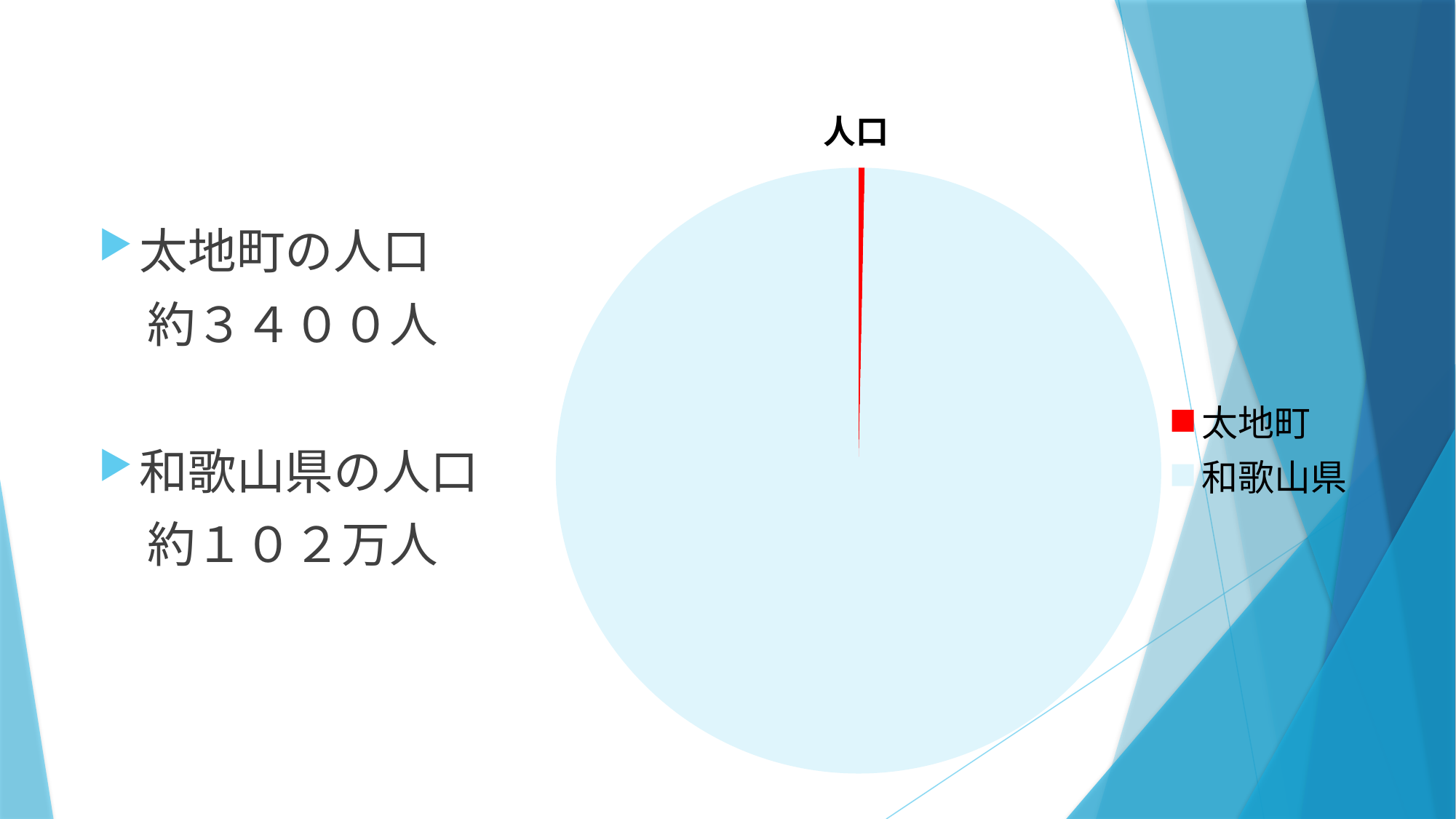
How many slices does the pie chart have? 2 Which is larger in the pie chart, 太地町 or 和歌山県? 和歌山県 What kind of chart is shown on the slide? pie chart What is the title of the chart? 人口 Which category has the smallest slice of the pie? 太地町 Which category has the largest slice of the pie? 和歌山県 What colour is the slice for 太地町? red How many entries does the legend list? 2